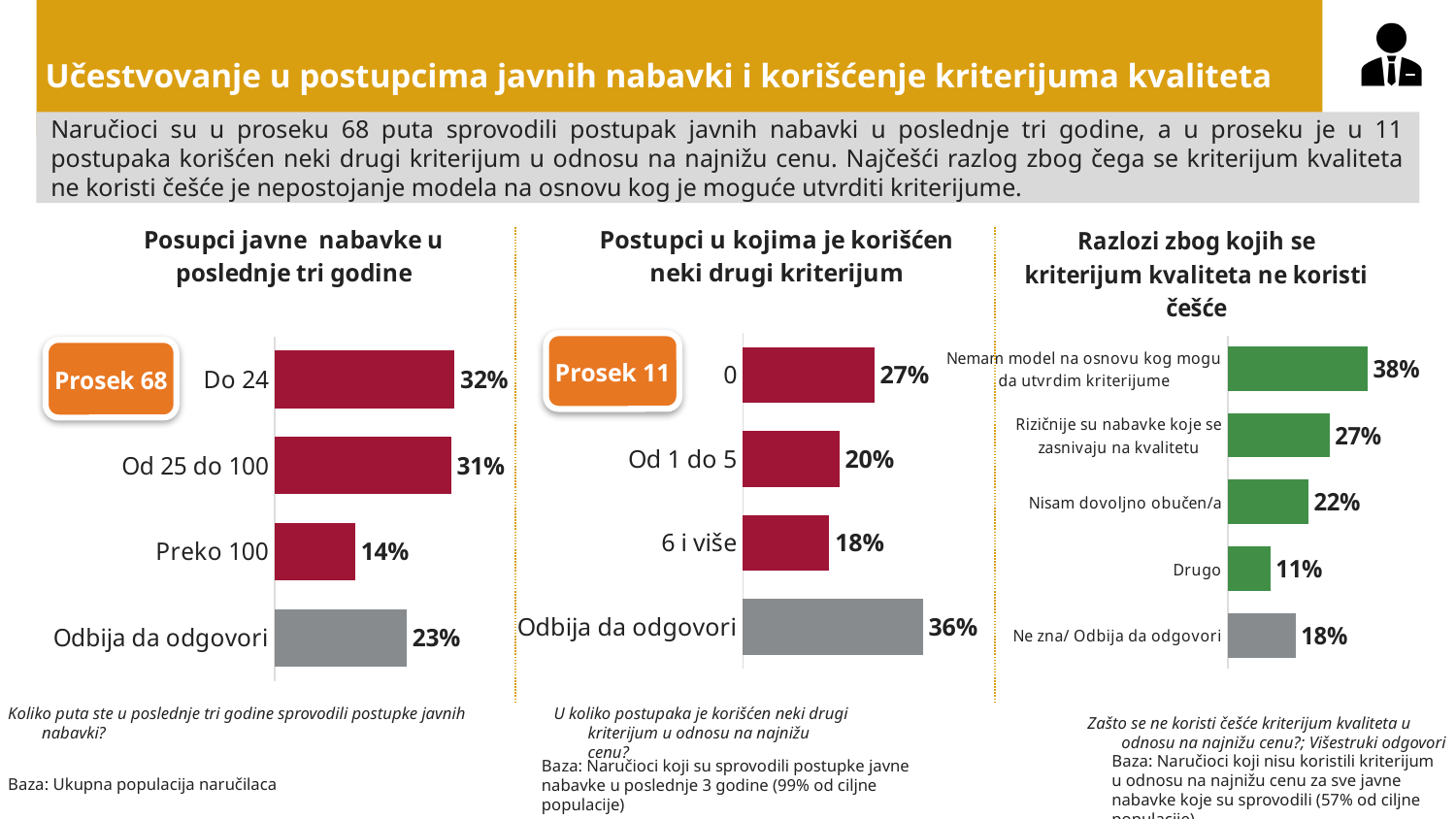
In the chart 'Posupci javne nabavke u poslednje tri godine', which category has the lowest value? Preko 100 In the chart 'Posupci javne nabavke u poslednje tri godine', what is the difference between 'Odbija da odgovori' and 'Preko 100'? 9 percentage points In the chart 'Razlozi zbog kojih se kriterijum kvaliteta ne koristi češće', how many categories are shown? 5 In the chart 'Posupci javne nabavke u poslednje tri godine', what is the value for 'Do 24'? 32% In the chart 'Postupci u kojima je korišćen neki drugi kriterijum', how many categories are shown? 4 In the chart 'Razlozi zbog kojih se kriterijum kvaliteta ne koristi češće', which category has the highest value? Nemam model na osnovu kog mogu da utvrdim kriterijume What type of chart is 'Posupci javne nabavke u poslednje tri godine'? Bar chart In the chart 'Razlozi zbog kojih se kriterijum kvaliteta ne koristi češće', which is larger: 'Drugo' or 'Ne zna/ Odbija da odgovori'? Ne zna/ Odbija da odgovori In the chart 'Postupci u kojima je korišćen neki drugi kriterijum', which category has the highest value? Odbija da odgovori In the chart 'Posupci javne nabavke u poslednje tri godine', what is the value for 'Preko 100'? 14% In the chart 'Postupci u kojima je korišćen neki drugi kriterijum', what is the value for '6 i više'? 18% In the chart 'Razlozi zbog kojih se kriterijum kvaliteta ne koristi češće', what is the value for 'Nisam dovoljno obučen/a'? 22%